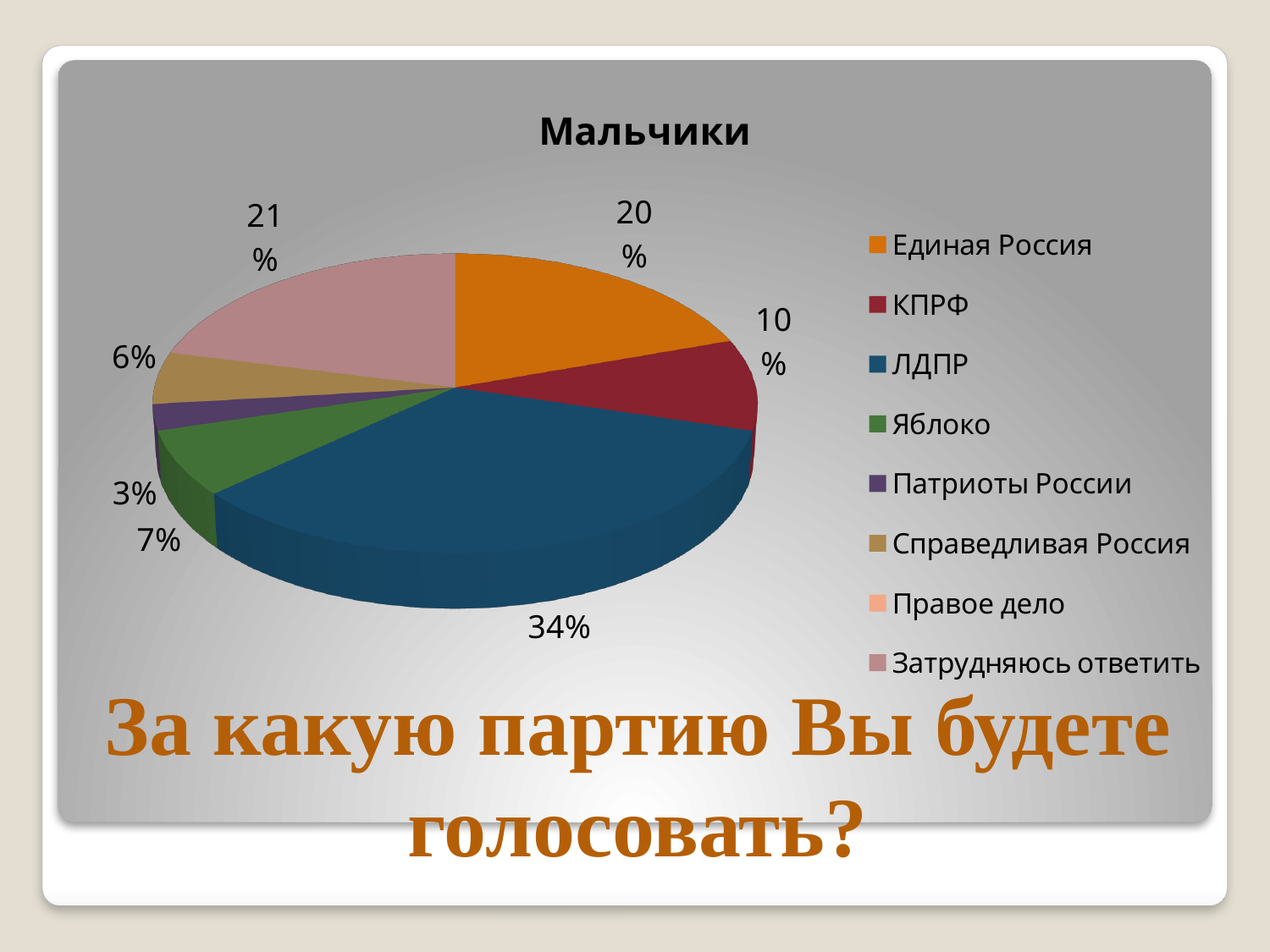
How many entries does the legend list? 8 Which is larger, the share for Затрудняюсь ответить or the share for КПРФ? Затрудняюсь ответить What type of chart is shown on the slide? pie chart What share of the pie does Яблоко have? 7% What share of the pie does Затрудняюсь ответить have? 21% What is the title of the chart? Мальчики Which party has the largest slice of the pie? ЛДПР What share of the pie does КПРФ have? 10% What share of the pie does ЛДПР have? 34% What is the difference between the shares of ЛДПР and Единая Россия? 14% What share of the pie does Единая Россия have? 20% Which labelled slice is the smallest in the pie? Патриоты России